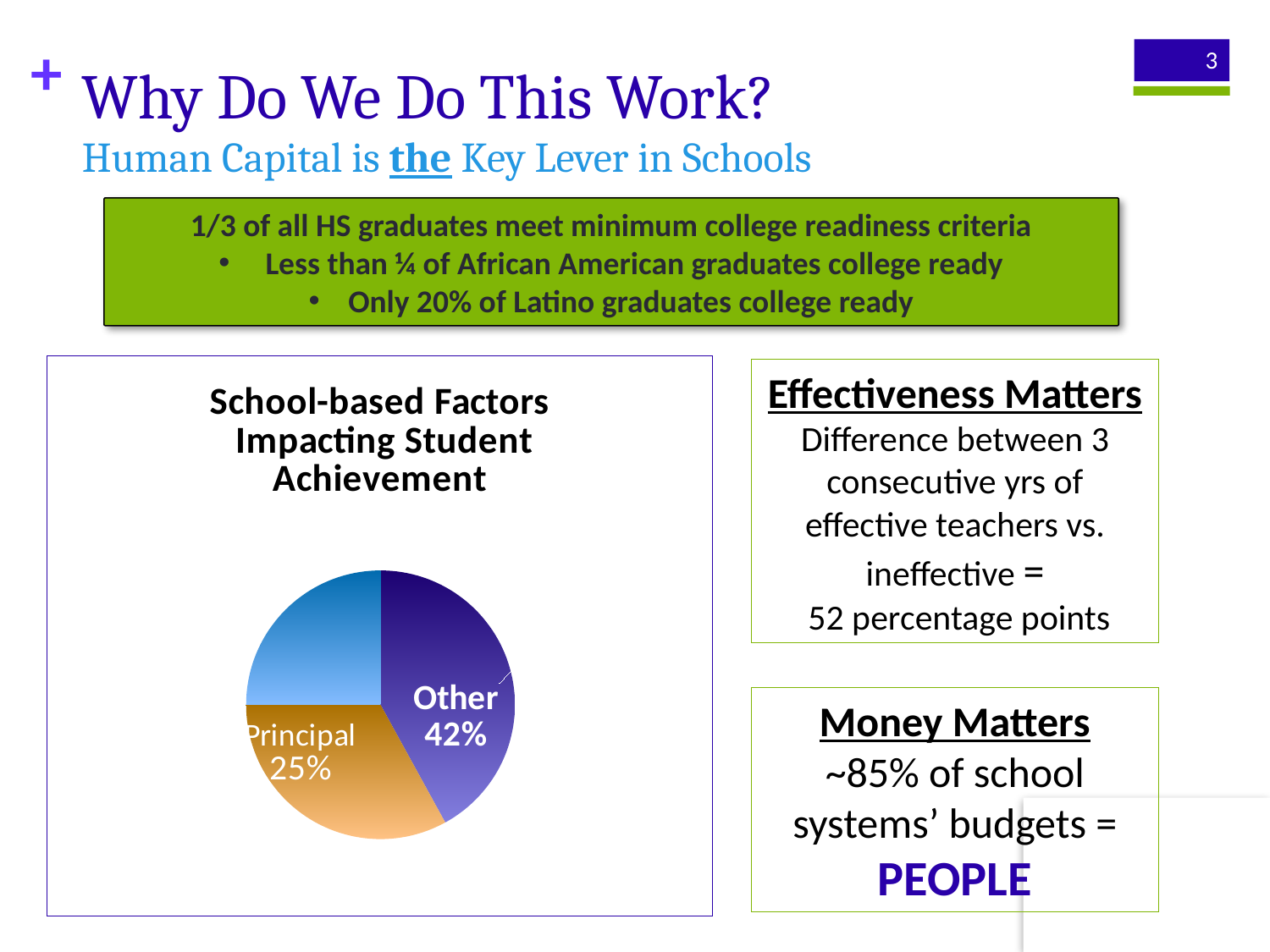
What percentage does the Principal slice represent in the School-based Factors Impacting Student Achievement pie chart? 25% What colour is the Principal slice in the pie chart? Orange By how many percentage points does the Other slice exceed the Principal slice in the pie chart? 17 percentage points What percentage does the Other slice represent in the School-based Factors Impacting Student Achievement pie chart? 42% What type of chart is used to show School-based Factors Impacting Student Achievement? Pie chart Which slice is the largest in the School-based Factors Impacting Student Achievement pie chart? Other What share of the pie does the Principal slice account for? 25% What is the title of the chart on the slide? School-based Factors Impacting Student Achievement In the pie chart, which labeled slice is larger: Other or Principal? Other How many slices does the School-based Factors Impacting Student Achievement pie chart have? 3